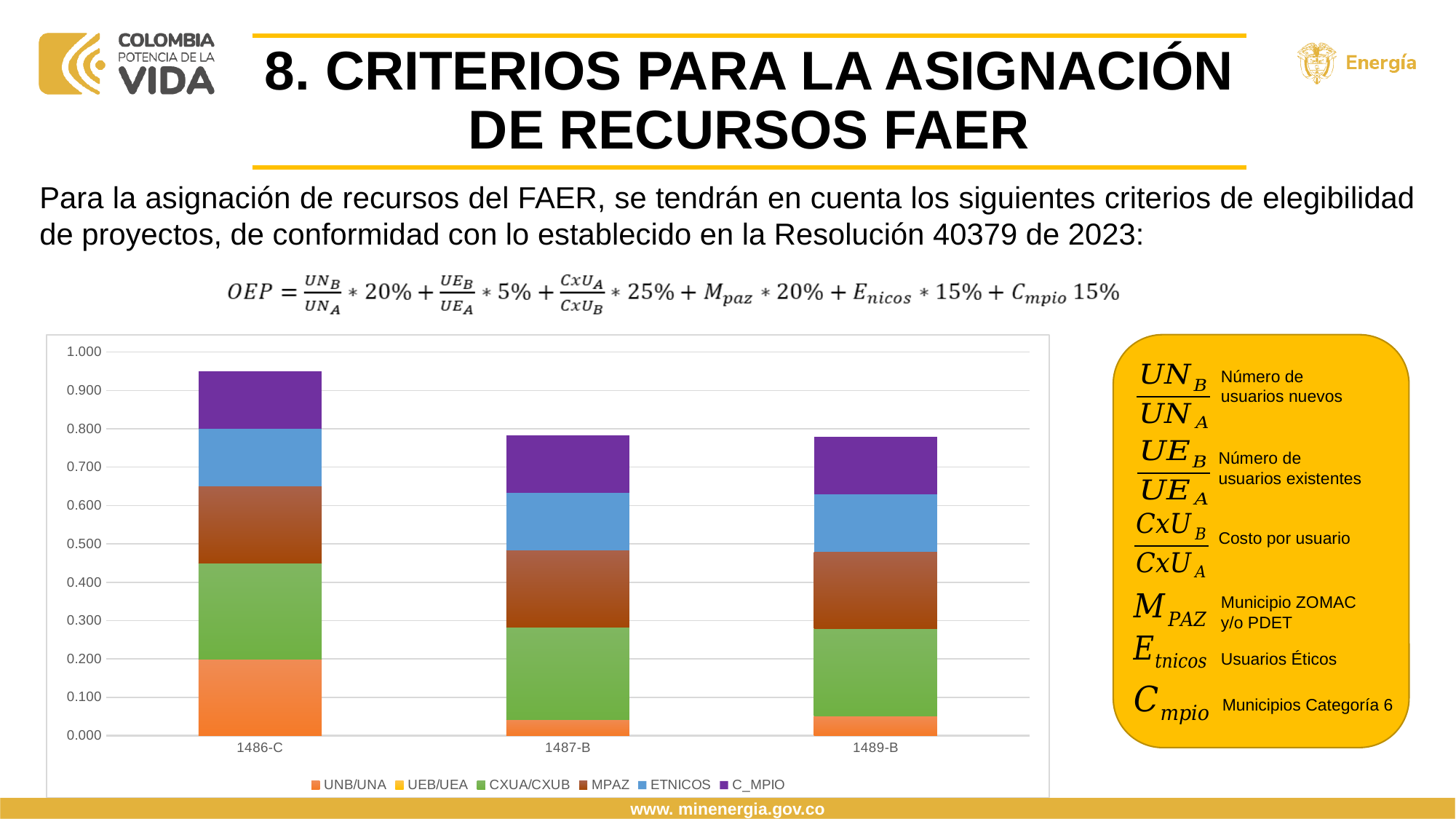
Which has the larger total stacked bar, 1486-C or 1489-B? 1486-C Is the UNB/UNA segment for 1486-C greater or less than 0.100? greater Is the total stacked value for 1486-C greater or less than 0.900? greater Is the UNB/UNA segment for 1487-B greater or less than 0.100? less Does the total stacked value rise or fall from 1486-C to 1487-B? fall How many categories (projects) are shown on the x axis of the chart? 3 Which category has the highest total stacked bar? 1486-C How many series does the chart legend list? 6 Which colour represents the C_MPIO series in the chart legend? Purple What kind of chart is shown on the slide? Stacked bar chart